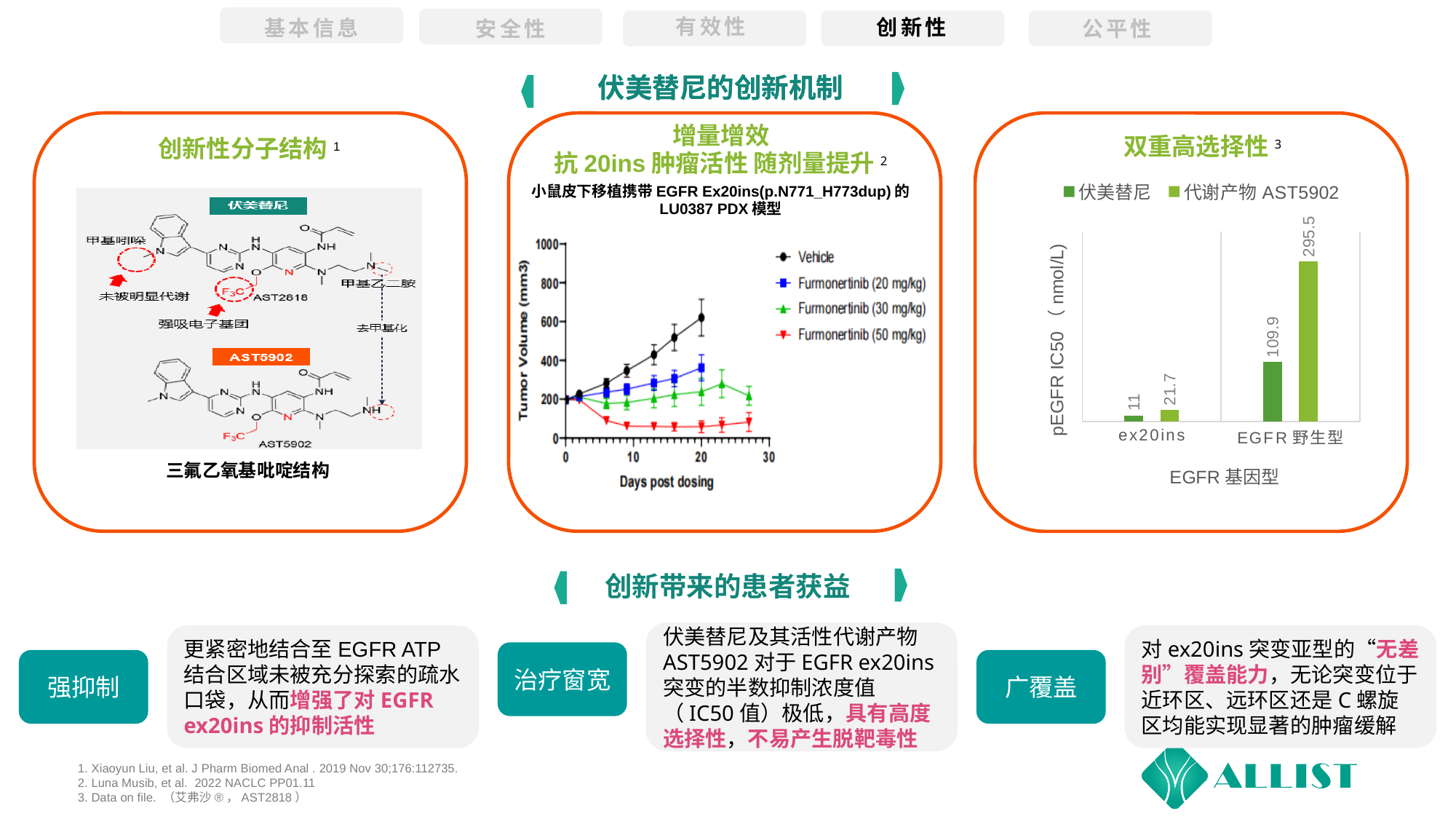
In the bar chart titled 双重高选择性, how many EGFR genotype categories are shown on the x axis? 2 In the bar chart titled 双重高选择性, what is the pEGFR IC50 value for 代谢产物 AST5902 on EGFR 野生型? 295.5 In the bar chart titled 双重高选择性, what is the pEGFR IC50 value for 代谢产物 AST5902 on ex20ins? 21.7 In the bar chart titled 双重高选择性, which bar has the highest value? 代谢产物 AST5902 on EGFR 野生型 In the bar chart titled 双重高选择性, what is the difference between the 代谢产物 AST5902 value and the 伏美替尼 value on EGFR 野生型? 185.6 In the line chart in the middle panel (Tumor Volume vs Days post dosing), how many series does the legend list? 4 In the bar chart titled 双重高选择性, what is the pEGFR IC50 value for 伏美替尼 on EGFR 野生型? 109.9 In the line chart in the middle panel, does the tumor volume for Furmonertinib (50 mg/kg) rise or fall over the days post dosing? fall In the line chart in the middle panel, is the Vehicle tumor volume at day 20 greater or less than 400? greater What kind of chart is shown in the 双重高选择性 panel on the right? bar chart In the bar chart titled 双重高选择性, how many series does the legend list? 2 In the bar chart titled 双重高选择性, what is the pEGFR IC50 value for 伏美替尼 on ex20ins? 11